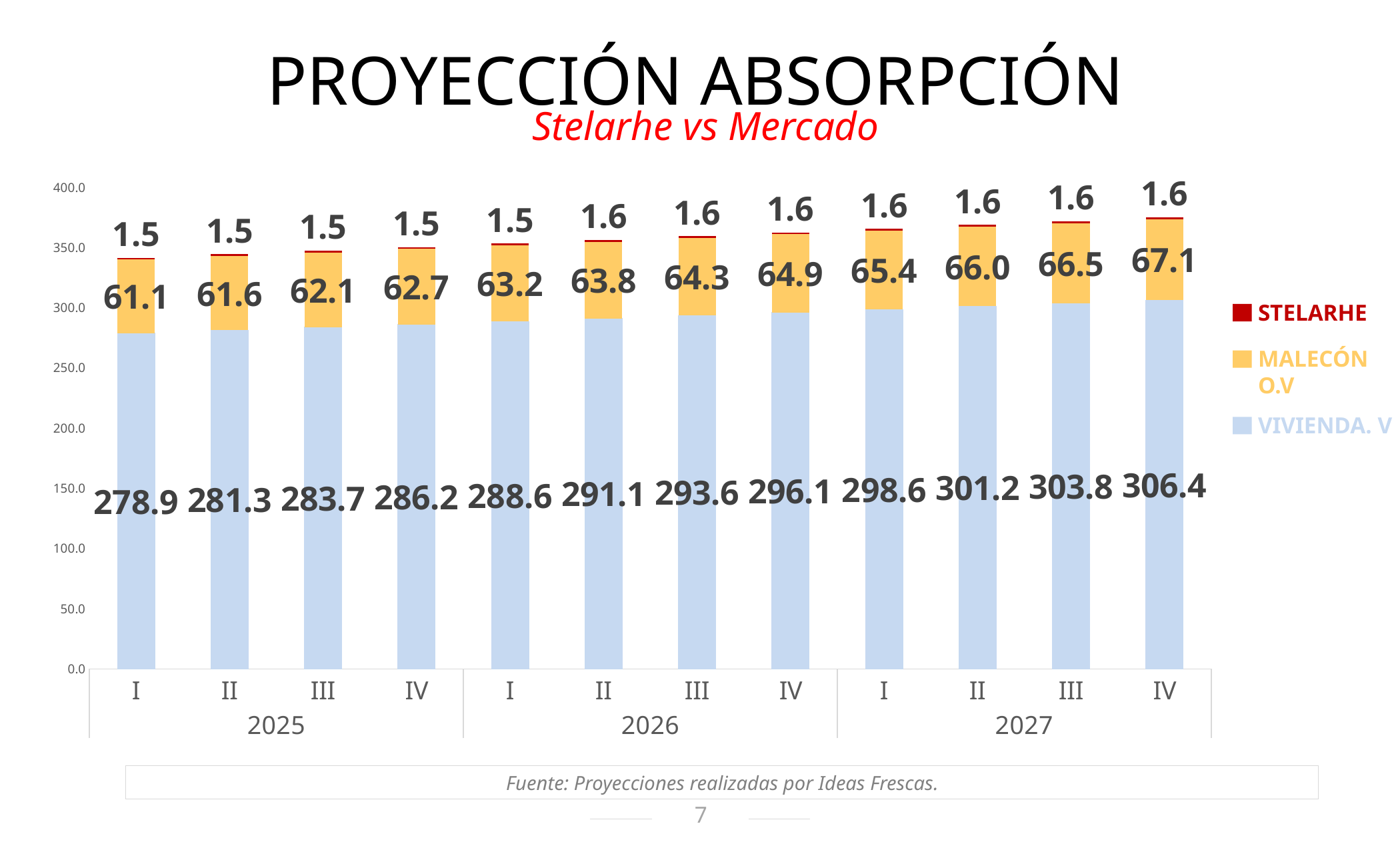
What is the total of the stacked bar for quarter I of 2025? 341.5 What is the VIVIENDA. V value for quarter I of 2025? 278.9 Do the VIVIENDA. V values rise or fall from quarter I of 2025 to quarter IV of 2027? Rise What is the STELARHE value for quarter II of 2026? 1.6 How many quarters are plotted on the x axis? 12 Which is larger, the MALECÓN O.V value in quarter III of 2026 or in quarter I of 2027? I 2027 What is the difference between the VIVIENDA. V value in quarter IV of 2027 and quarter I of 2025? 27.5 What is the MALECÓN O.V value for quarter IV of 2027? 67.1 What kind of chart is shown on the slide? Stacked bar chart In which quarter is the MALECÓN O.V value lowest? I 2025 In which quarter is the VIVIENDA. V value highest? IV 2027 How many series does the legend list? 3